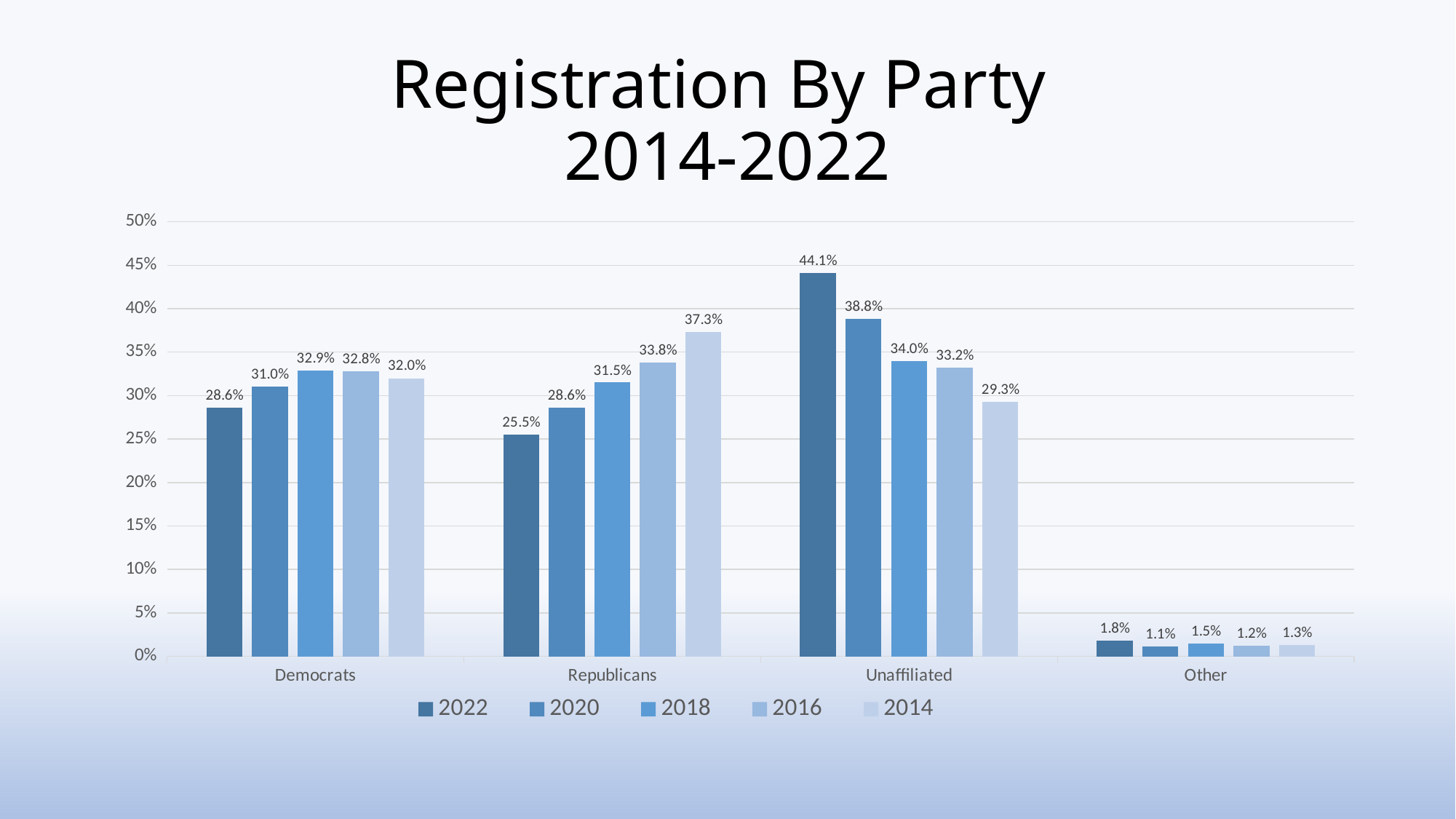
Which category has the highest 2022 value? Unaffiliated How many categories are shown on the x axis? 4 How many series does the legend list? 5 What is the difference between the 2022 and 2014 values for Unaffiliated? 14.8% What is the 2018 registration value for Democrats? 32.9% What is the title of the chart? Registration By Party 2014-2022 What is the 2022 registration value for Unaffiliated? 44.1% What kind of chart is shown on the slide? Bar chart What is the 2014 registration value for Republicans? 37.3% Which is larger for Republicans: the 2022 value or the 2014 value? 2014 Do the Unaffiliated values rise or fall from 2014 to 2022? Rise Which category has the lowest 2020 value? Other